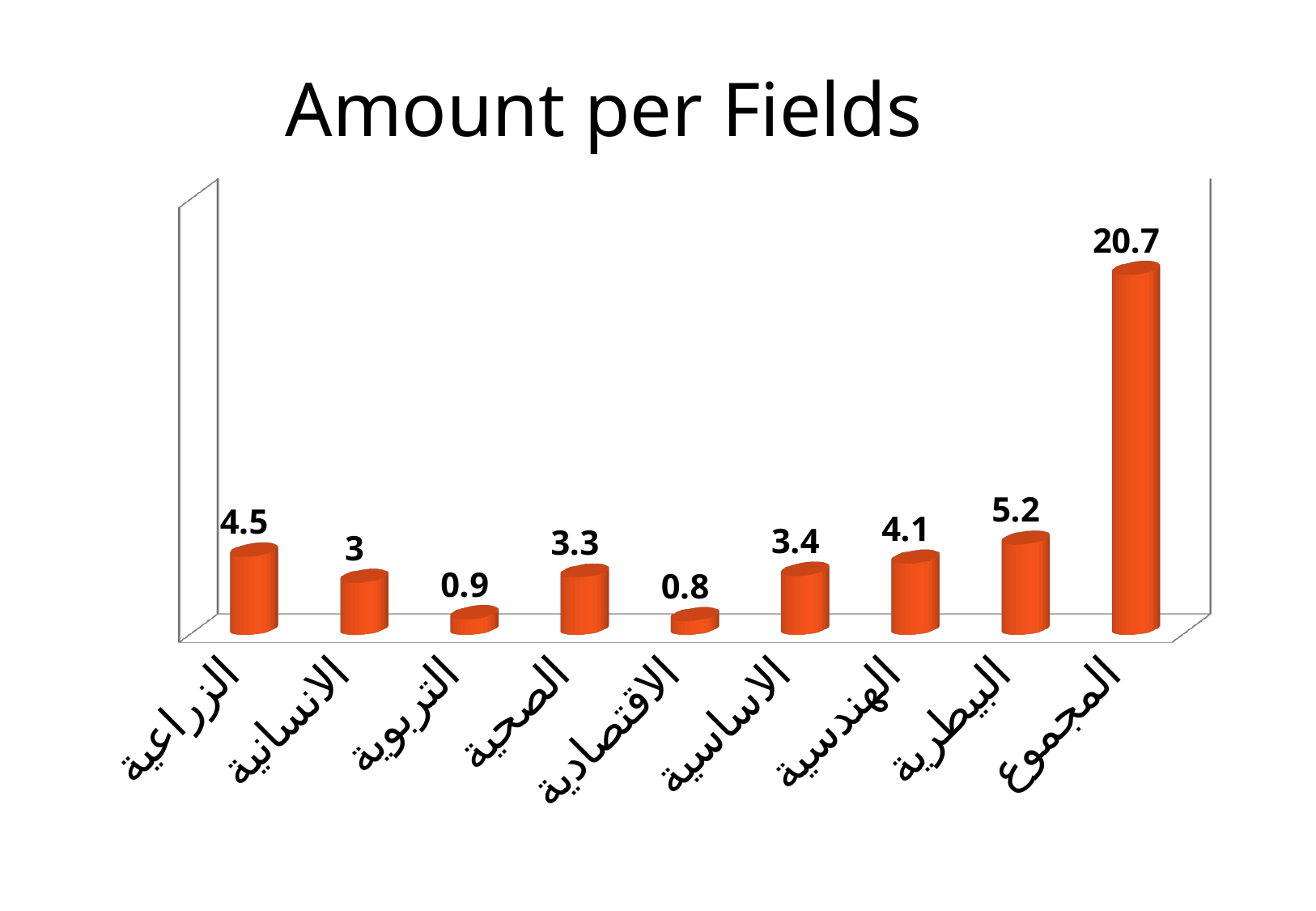
How many categories are shown on the x axis? 9 What is the value for الاقتصادية? 0.8 What is the value for المجموع? 20.7 Which category has the lowest value? الاقتصادية Which category has the highest value? المجموع What is the value for الزراعية? 4.5 What is the title of the chart? Amount per Fields What kind of chart is shown on the slide? Bar chart What is the difference between the values for الصحية and التربوية? 2.4 What is the value for البيطرية? 5.2 What is the difference between the values for البيطرية and الهندسية? 1.1 Which is larger, the value for الزراعية or the value for الانسانية? الزراعية